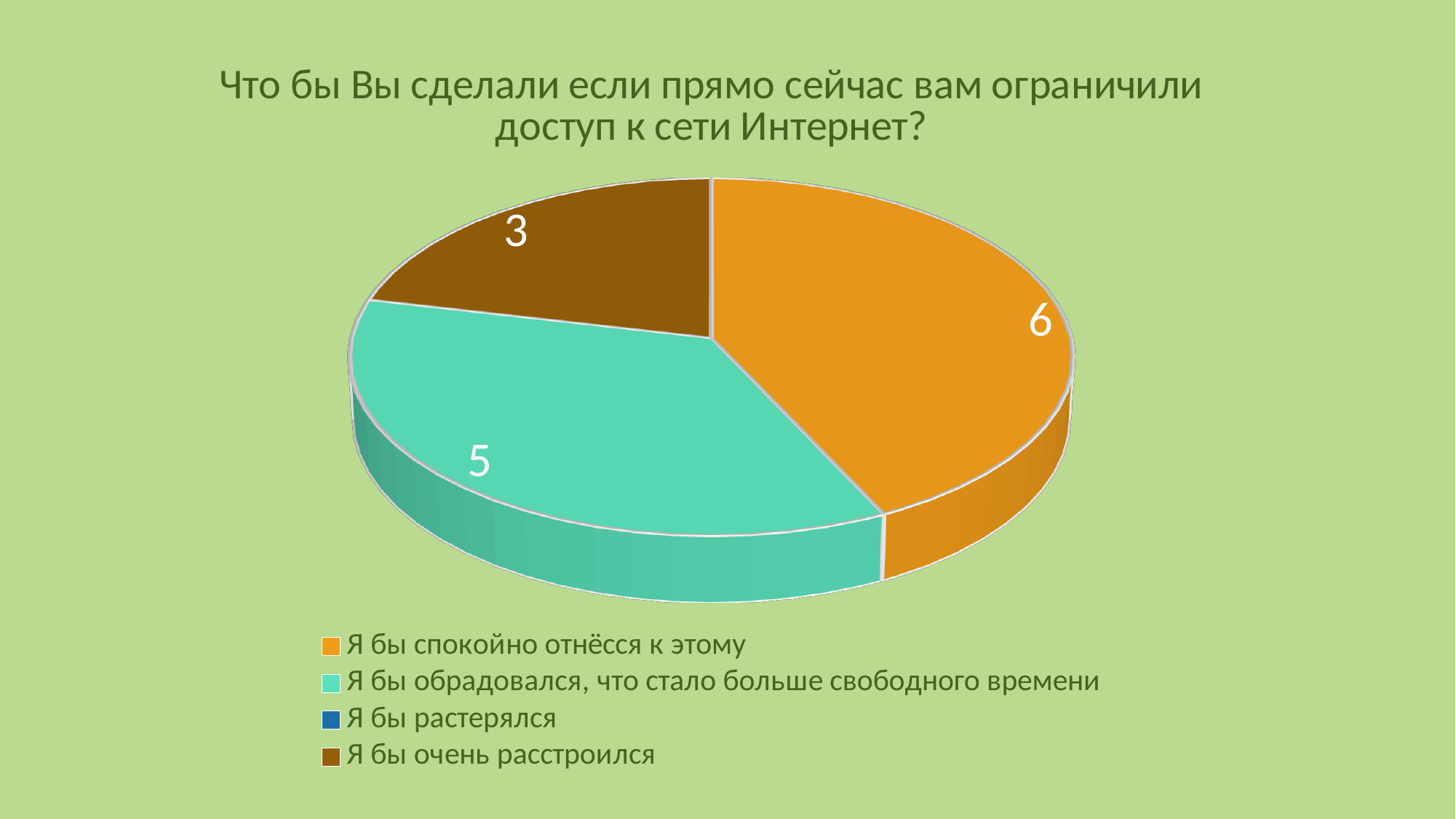
Which answer option with a visible slice has the smallest value? Я бы очень расстроился What is the value for "Я бы очень расстроился"? 3 Which answer option has the largest slice of the pie? Я бы спокойно отнёсся к этому What is the difference between the values for "Я бы спокойно отнёсся к этому" and "Я бы очень расстроился"? 3 How many entries does the legend list? 4 What kind of chart is shown on the slide? pie chart Which is larger: the value for "Я бы спокойно отнёсся к этому" or for "Я бы обрадовался, что стало больше свободного времени"? Я бы спокойно отнёсся к этому How many slices with data labels are visible in the pie? 3 What is the value for "Я бы спокойно отнёсся к этому"? 6 What colour is the slice for "Я бы очень расстроился"? brown What is the difference between the values for "Я бы обрадовался, что стало больше свободного времени" and "Я бы очень расстроился"? 2 What is the value for "Я бы обрадовался, что стало больше свободного времени"? 5